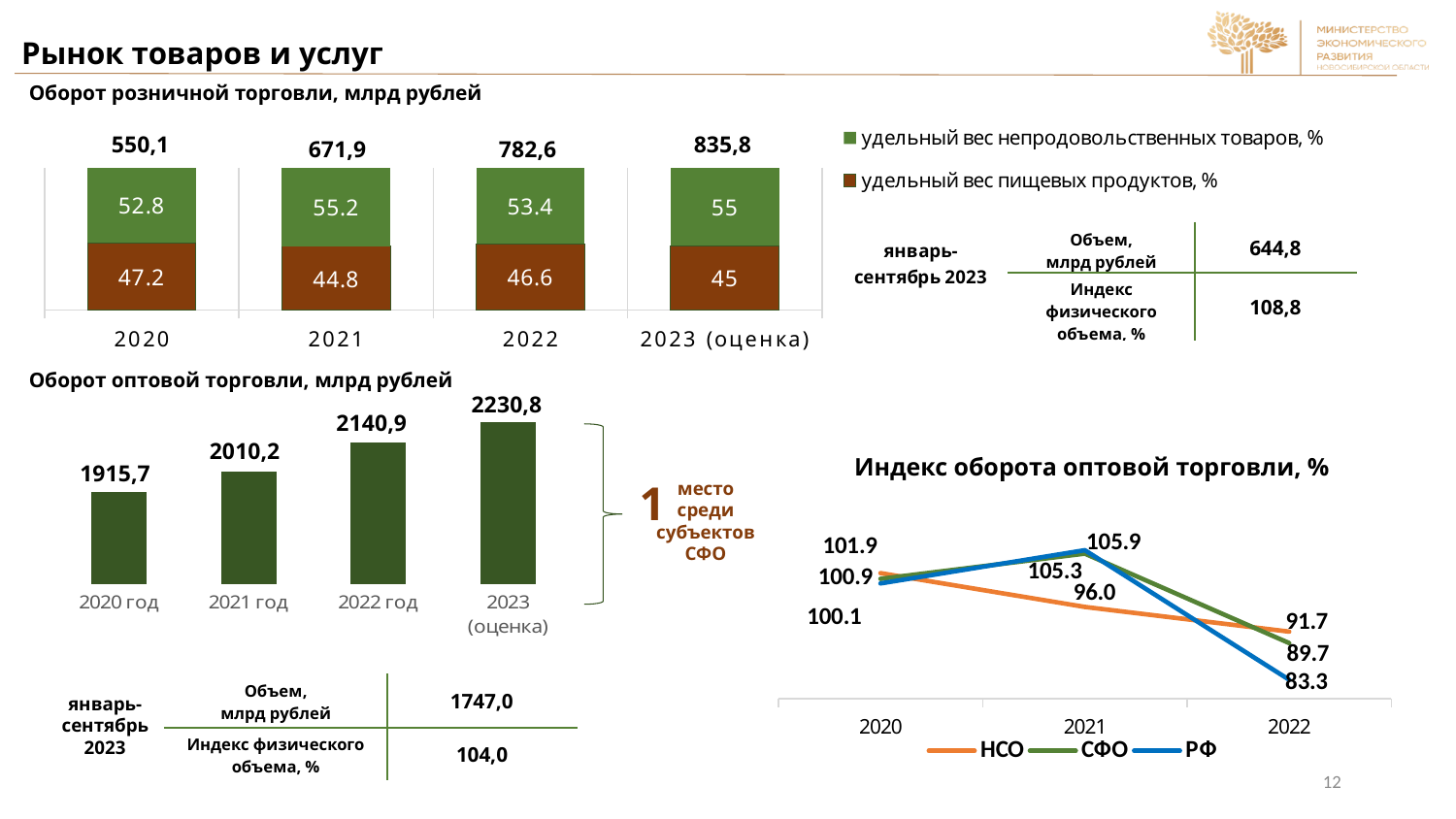
In the 'Индекс оборота оптовой торговли, %' chart, what is the value for СФО in 2021? 105.3 In the 'Оборот оптовой торговли, млрд рублей' chart, what is the difference between the 2023 (оценка) value and the 2022 год value? 89,9 In the 'Оборот розничной торговли, млрд рублей' chart, which year has the highest total? 2023 (оценка) In the 'Оборот розничной торговли, млрд рублей' chart, what is the value of 'удельный вес непродовольственных товаров, %' for 2021? 55.2 How many series does the legend of the 'Индекс оборота оптовой торговли, %' chart list? 3 In the 'Оборот оптовой торговли, млрд рублей' chart, do the values rise or fall from 2020 to 2023? rise In the 'Индекс оборота оптовой торговли, %' chart, what is the value for РФ in 2022? 83.3 How many series does the legend of the 'Оборот розничной торговли, млрд рублей' chart list? 2 What kind of chart is the 'Оборот розничной торговли, млрд рублей' chart? bar chart In the 'Оборот оптовой торговли, млрд рублей' chart, what is the value for 2021 год? 2010,2 In the 'Оборот розничной торговли, млрд рублей' chart, what is the value of 'удельный вес пищевых продуктов, %' for 2023 (оценка)? 45 In the 'Оборот розничной торговли, млрд рублей' chart, what is the total value for 2022? 782,6